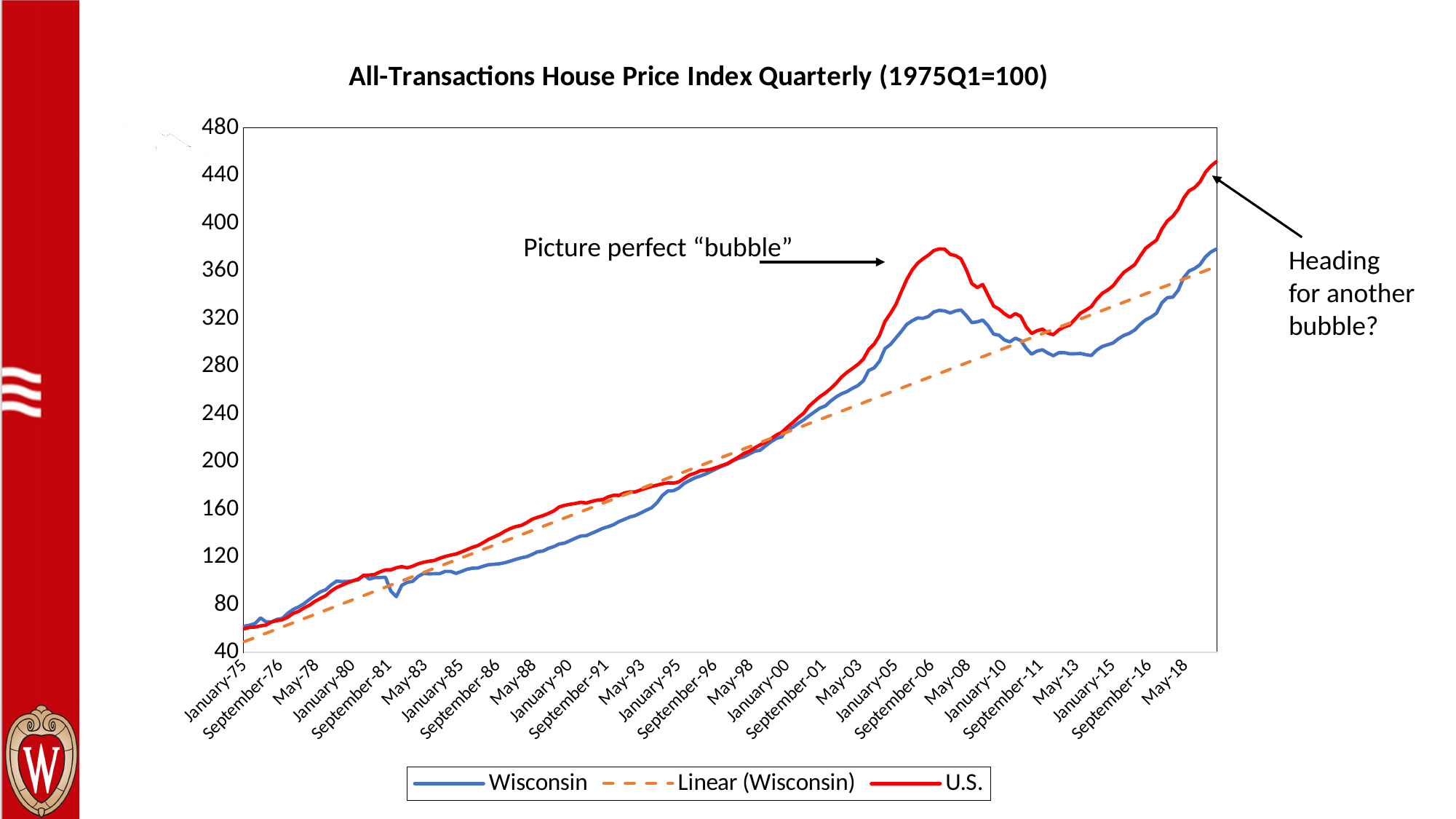
Around May-08, which series has the higher value, Wisconsin or U.S.? U.S. Is the value of the Wisconsin series at the right end of the chart (after May-18) greater or less than 320? greater What is the title of the chart? All-Transactions House Price Index Quarterly (1975Q1=100) Is the value of the U.S. series at the right end of the chart (after May-18) greater or less than 400? greater Which legend entry is drawn as a dashed line? Linear (Wisconsin) What kind of chart is shown on the slide? Line chart Overall, do the Wisconsin and U.S. index values rise or fall from January-75 to May-18? rise How many series does the legend list? 3 Which series reaches the highest value on the chart? U.S. Is the value of the Wisconsin series around May-13 greater or less than 320? less